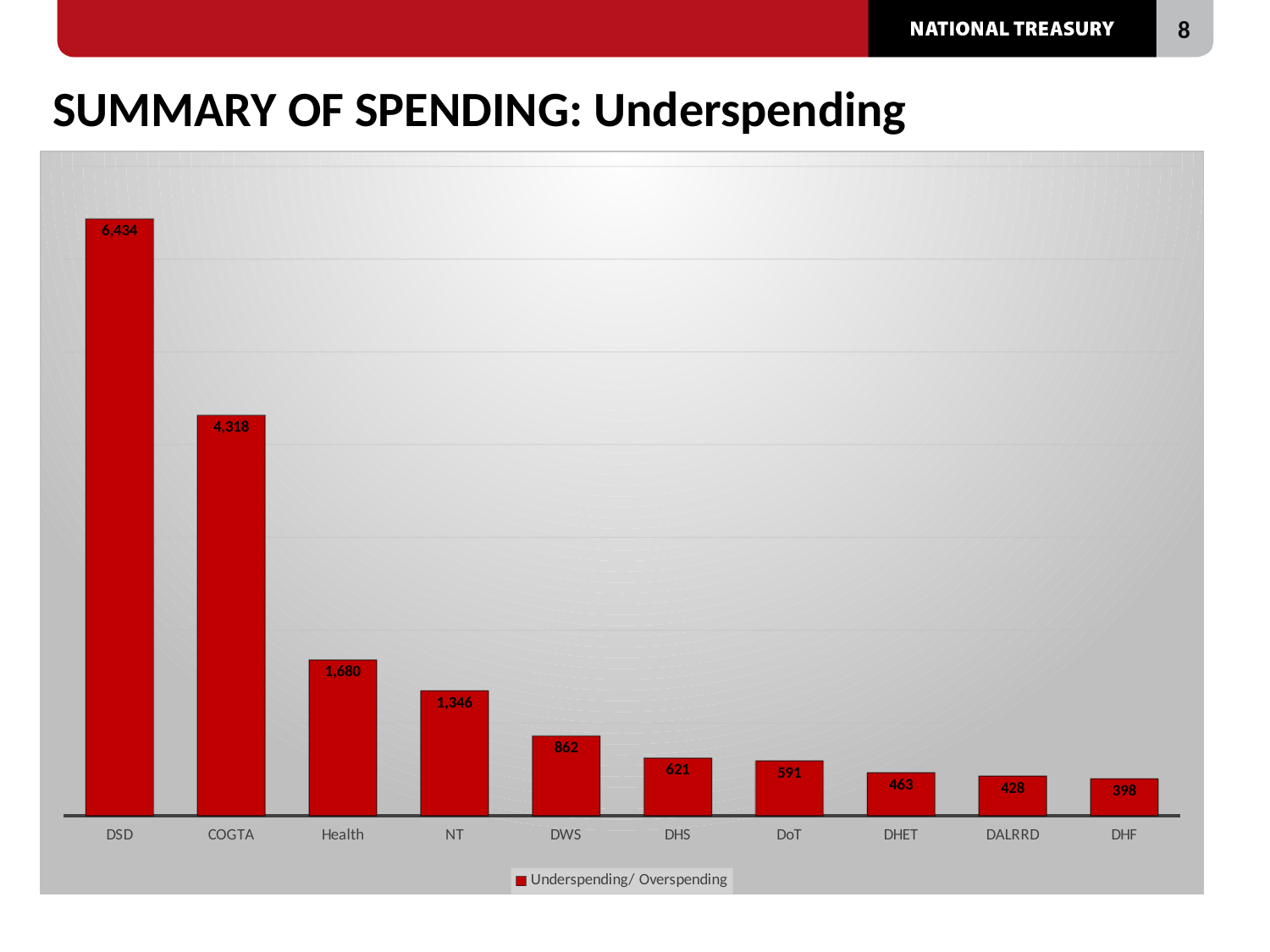
What is the value for DoT? 591 How many series does the legend list? 1 How many categories are shown on the x axis? 10 What is the difference between the values for DSD and COGTA? 2,116 Which category has the lowest value? DHF What is the difference between the values for NT and DWS? 484 Which is larger, the value for DHS or the value for DHET? DHS What is the legend entry for the series? Underspending/ Overspending What kind of chart is shown on the slide? bar chart Which category has the highest value? DSD What is the value for DSD? 6,434 What is the value for Health? 1,680